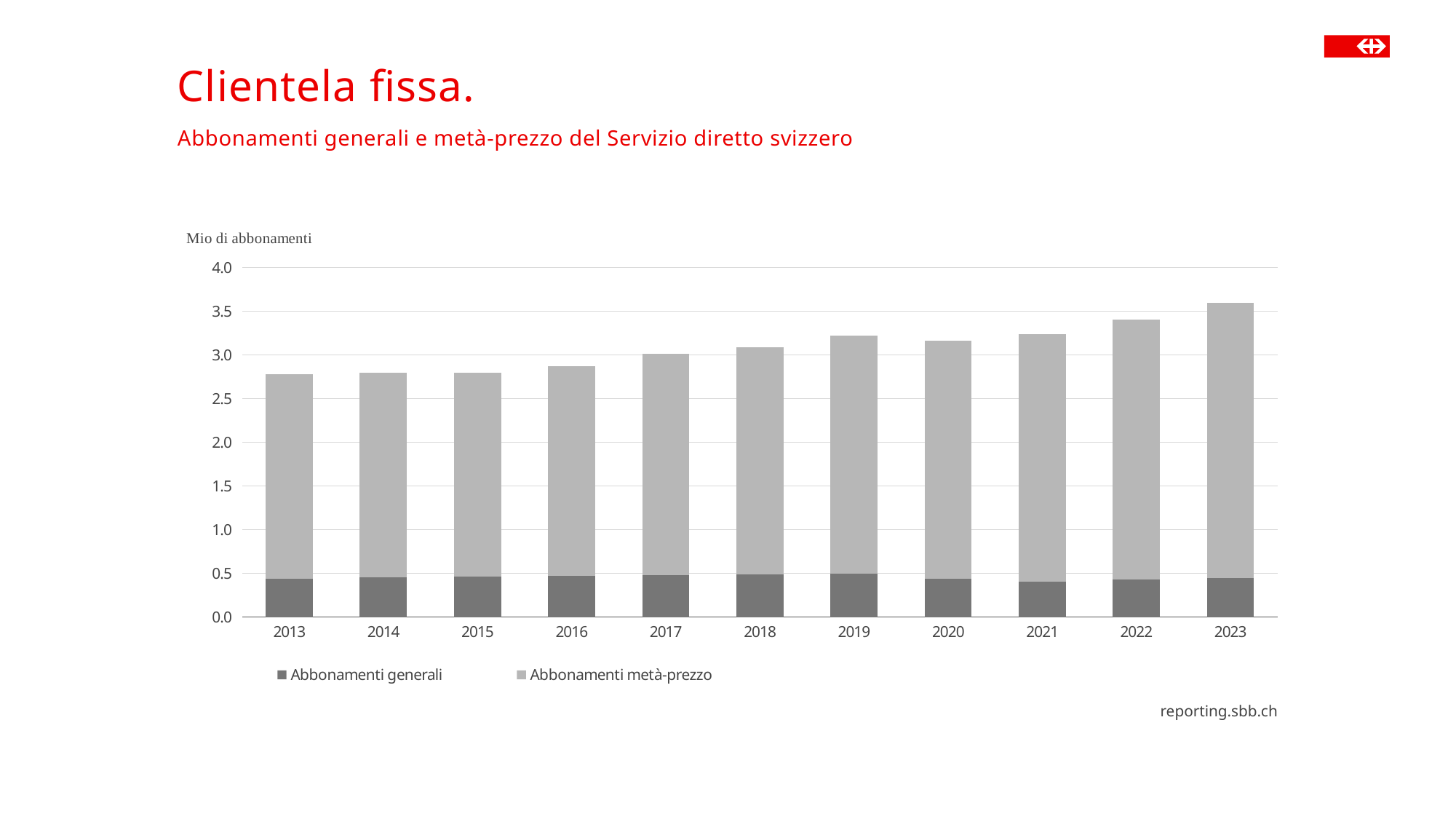
What unit label is shown above the y axis of the chart? Mio di abbonamenti Do the total values generally rise or fall from 2013 to 2023? rise What are the two series named in the chart legend? Abbonamenti generali and Abbonamenti metà-prezzo Which year has the highest total number of subscriptions in the chart? 2023 How many years are shown on the x axis of the chart? 11 How many series does the chart legend list? 2 Is the total value for 2022 greater or less than 3.0? greater What kind of chart is shown on the slide? Bar chart Is the value for Abbonamenti generali in 2013 greater or less than 0.5? less Is the total value for 2013 greater or less than 3.0? less Which year has the larger total number of subscriptions, 2013 or 2023? 2023